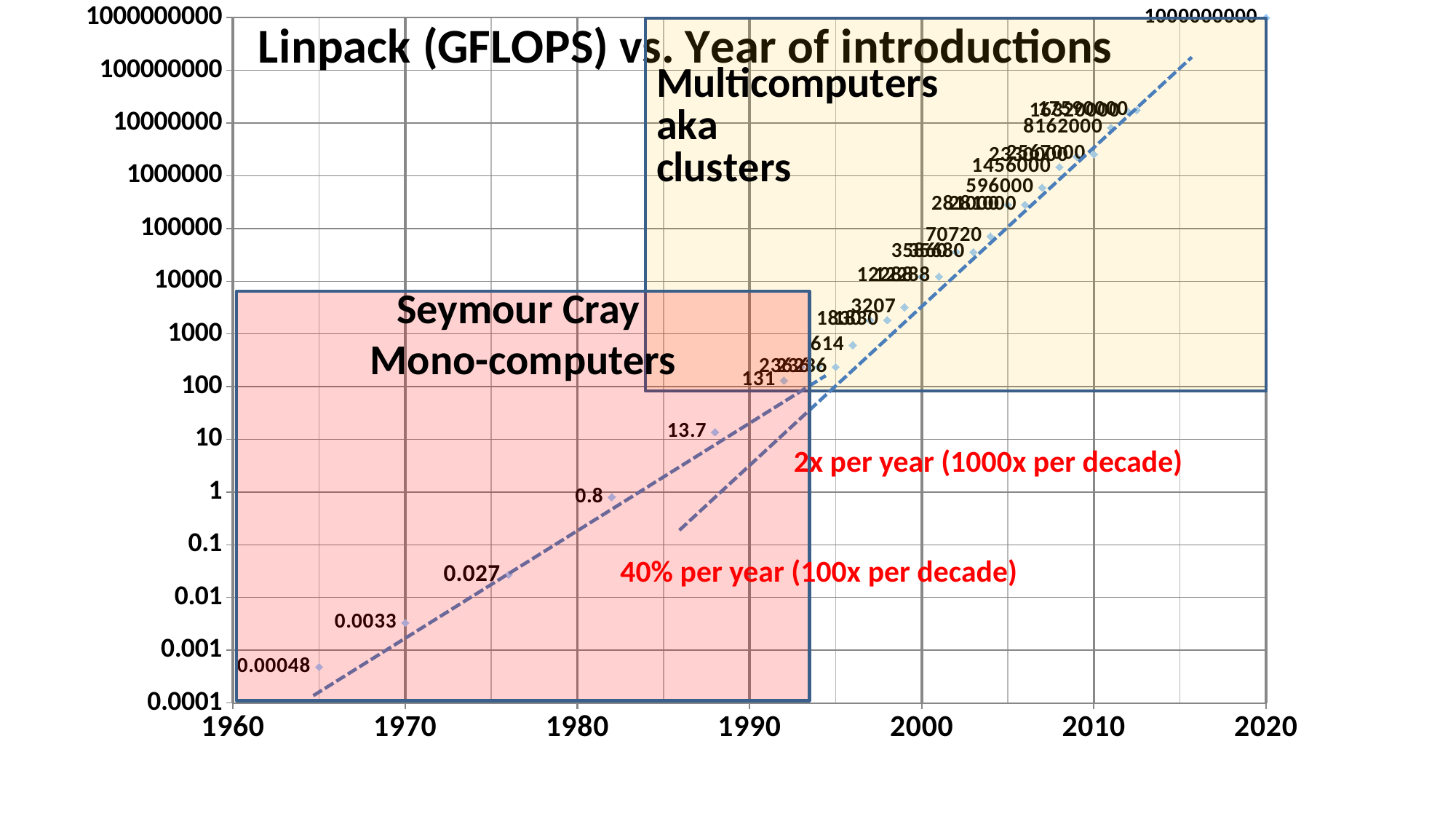
What is the labeled Linpack value for the point at 1970? 0.0033 What is the lowest labeled value on the chart? 0.00048 What is the labeled Linpack value for the point at 2020? 1000000000 What is the title of the chart? Linpack (GFLOPS) vs. Year of introductions What is the difference between the labeled values at 1988 and 1982? 12.9 Which is larger, the labeled value at 1988 or the labeled value at 1982? 1988 What kind of chart is shown on the slide? scatter chart Do the Linpack values rise or fall as the year increases along the x axis? rise What is the highest labeled value on the chart? 1000000000 Is the value for the point labeled 131 greater or less than 100? greater What is the labeled Linpack value for the point at 1982? 0.8 What is the labeled Linpack value for the point at 1988? 13.7